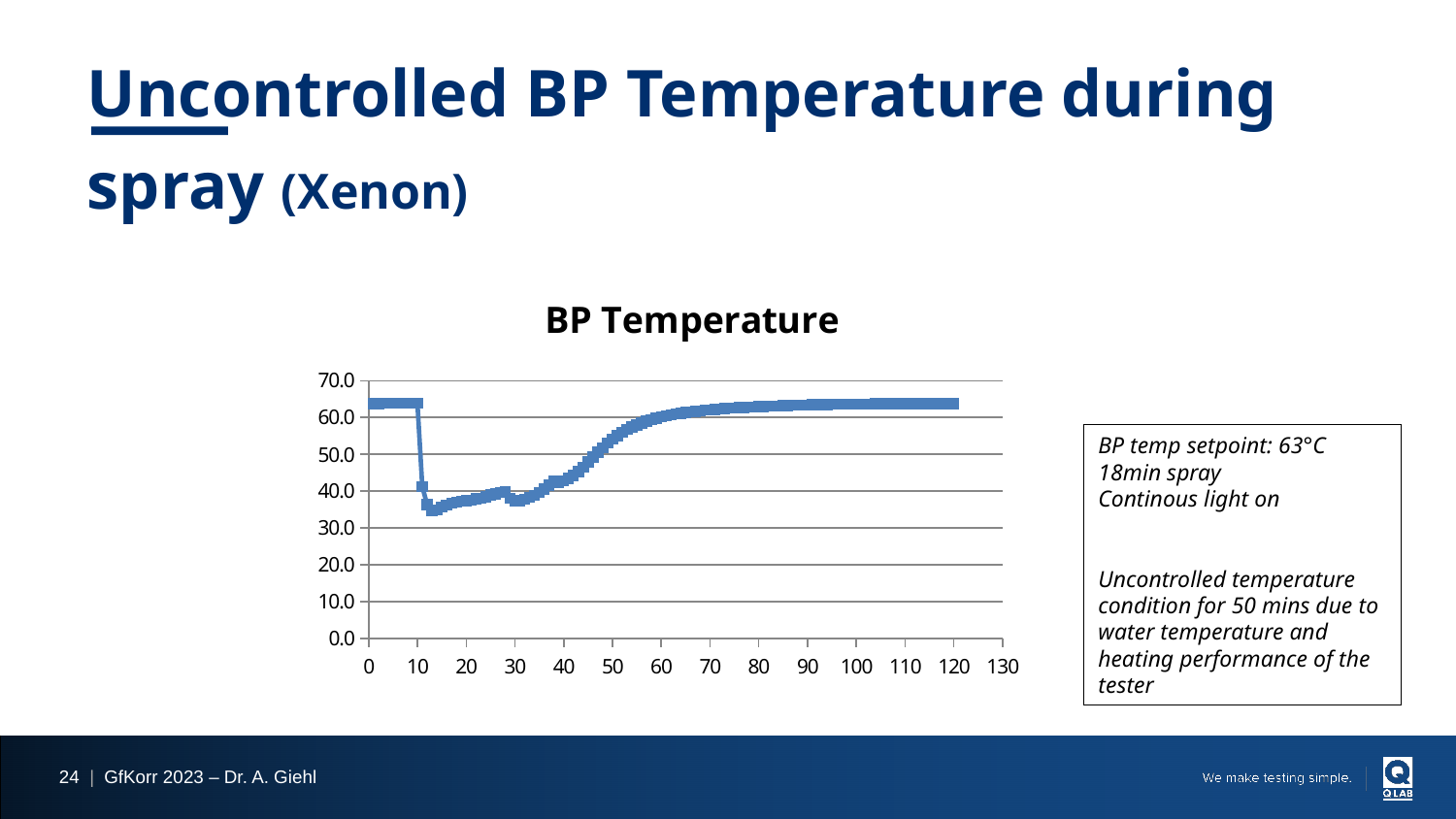
What kind of chart is shown on the slide? line chart Do the values rise or fall between x = 10 and x = 15? fall Is the value at x = 0 greater or less than 60? greater Is the value at x = 120 greater or less than 60? greater Do the values rise or fall between x = 40 and x = 60? rise Is the value at x = 60 greater or less than 50? greater Which is larger, the value at x = 0 or the value at x = 20? the value at x = 0 What is the title of the chart? BP Temperature What is the highest tick label shown on the y axis? 70.0